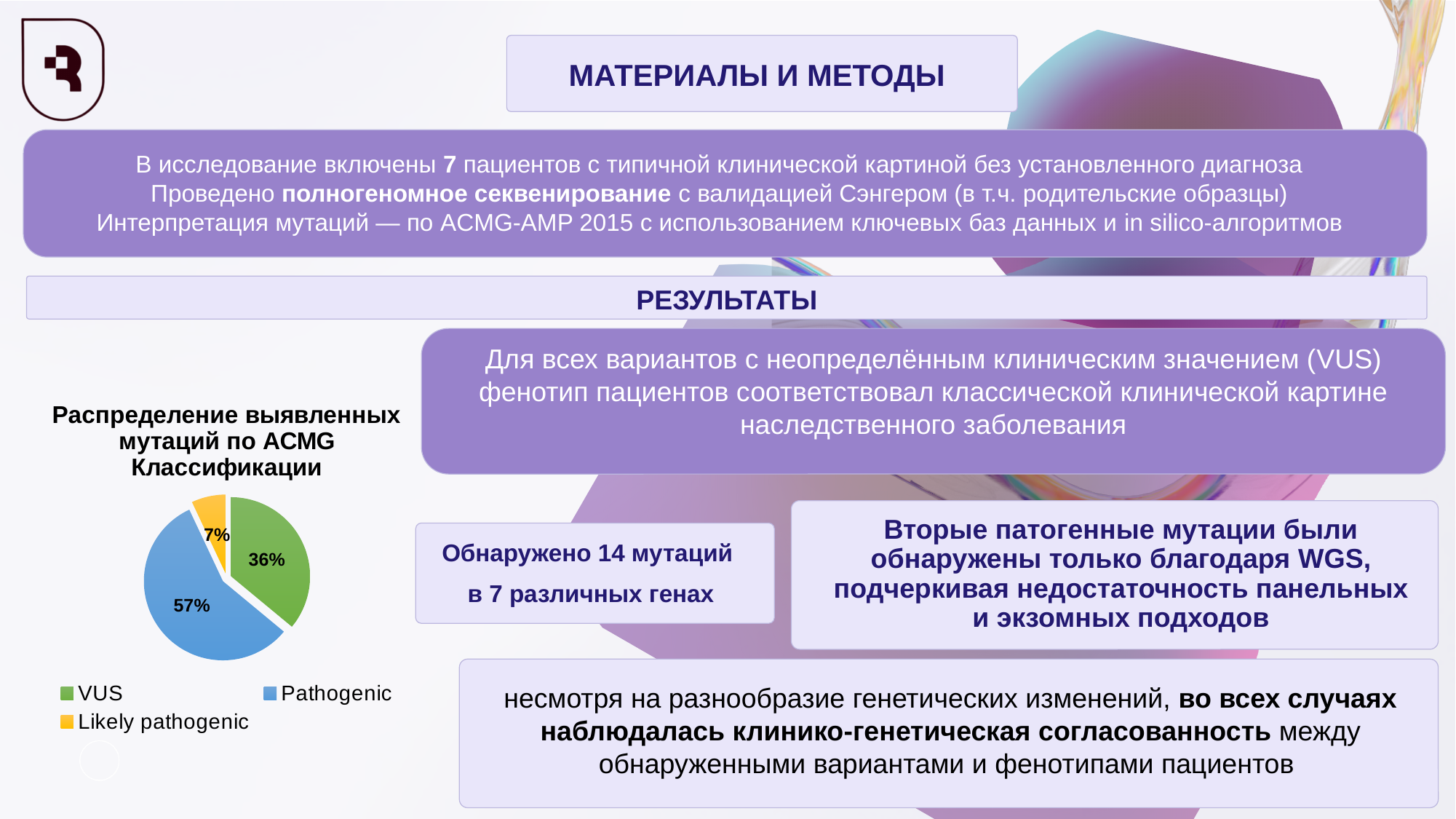
What is the difference in percentage points between the Pathogenic and VUS slices? 21 What share of the pie chart is labelled Pathogenic? 57% What share of the pie chart is labelled Likely pathogenic? 7% Which colour represents the Likely pathogenic category in the pie chart? yellow Which category has the smallest slice in the pie chart? Likely pathogenic Which category has the largest slice in the pie chart? Pathogenic What share of the pie chart is labelled VUS? 36% What is the title of the pie chart? Распределение выявленных мутаций по ACMG Классификации What is the difference in percentage points between the VUS and Likely pathogenic slices? 29 What type of chart is shown on the slide? pie chart How many categories does the pie chart show? 3 Which slice is larger, VUS or Likely pathogenic? VUS